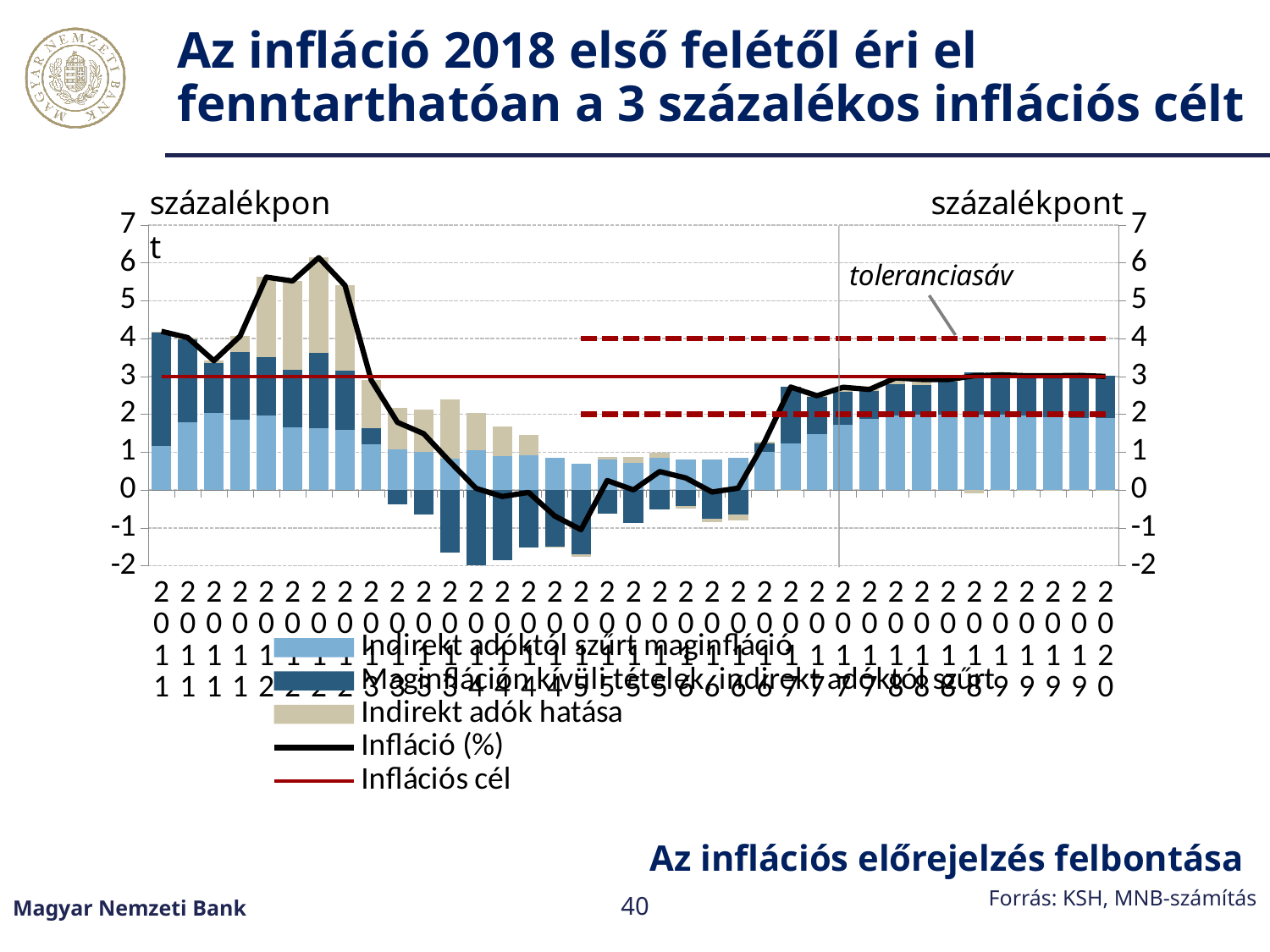
What is the lowest value shown on the vertical axis? -2 Between which two values on the axis are the dashed lines marking the toleranciasáv drawn? 2 and 4 At what value on the axis is the Inflációs cél line drawn? 3 What is the title of the chart shown below the plot area? Az inflációs előrejelzés felbontása What is the highest value shown on the vertical axis? 7 Is the highest point of the Infláció (%) line greater or less than 5? greater How many series does the legend list? 5 Does the Infláció (%) line rise or fall between its 2012 peak and 2015? fall Is the lowest point of the Infláció (%) line greater or less than 0? less What source is cited for the chart? KSH, MNB-számítás What kind of chart is shown on the slide? A stacked bar chart combined with line series Does the Infláció (%) line rise or fall from 2016 to 2018? rise